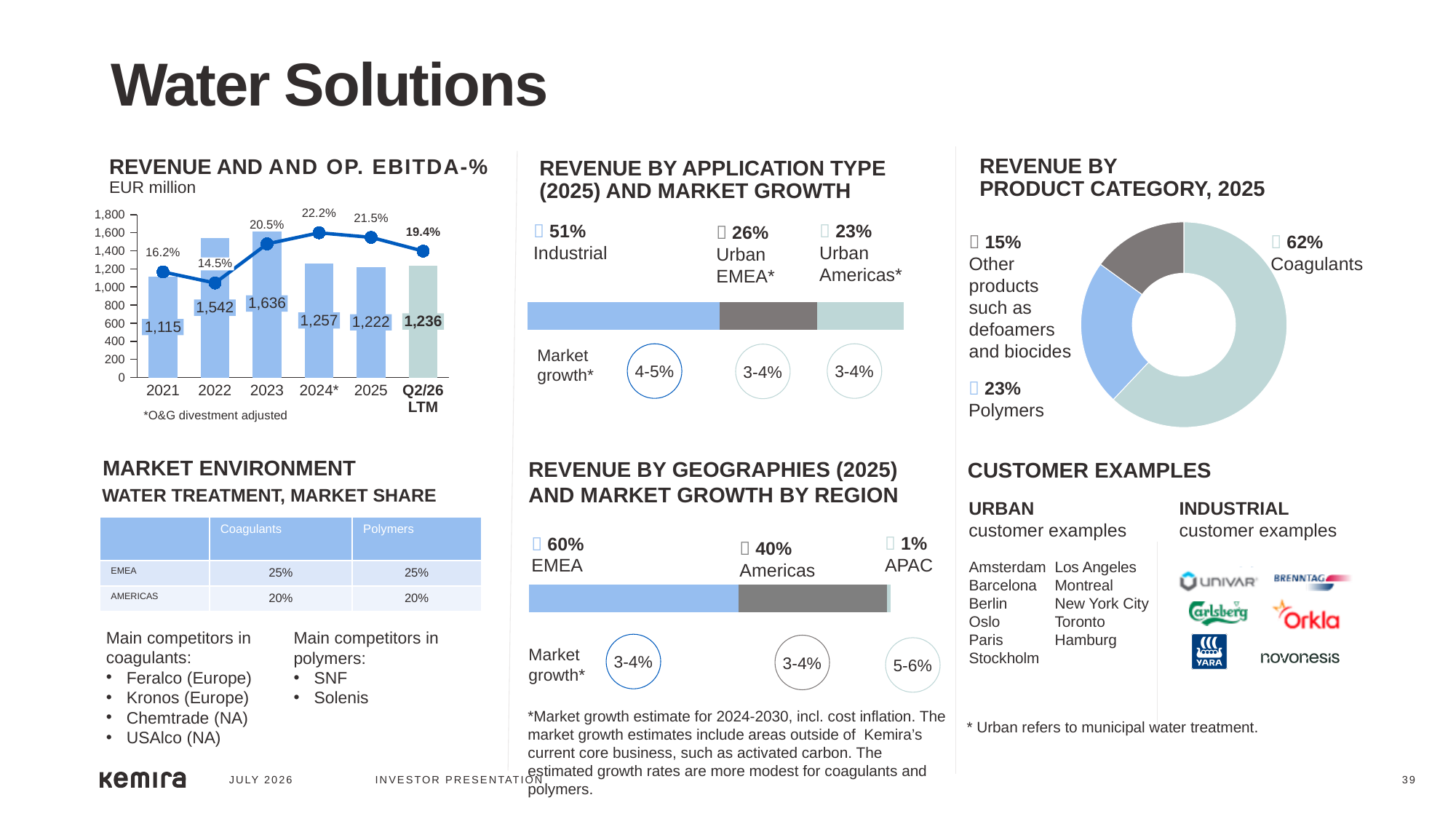
In the Revenue and Op. EBITDA-% chart, how many periods are shown on the x axis? 6 In the Revenue by Product Category, 2025 chart, which category has the smallest share? Other products such as defoamers and biocides In the Revenue by Geographies (2025) chart, what is the market growth estimate for APAC? 5-6% In the Revenue and Op. EBITDA-% chart, is revenue higher in 2025 or in Q2/26 LTM? Q2/26 LTM In the Revenue by Application Type (2025) chart, what share of revenue is Industrial? 51% In the Revenue by Product Category, 2025 chart, what share do Coagulants represent? 62% In the Revenue and Op. EBITDA-% chart, what was revenue in 2023? 1,636 In the Revenue and Op. EBITDA-% chart, which year had the highest revenue? 2023 In the Revenue and Op. EBITDA-% chart, which period has the highest Op. EBITDA-%? 2024* In the Revenue and Op. EBITDA-% chart, what was the Op. EBITDA-% in 2024*? 22.2% In the Revenue and Op. EBITDA-% chart, what is the difference in revenue between 2022 and 2021? 427 In the Revenue and Op. EBITDA-% chart, which year had the lowest revenue? 2021